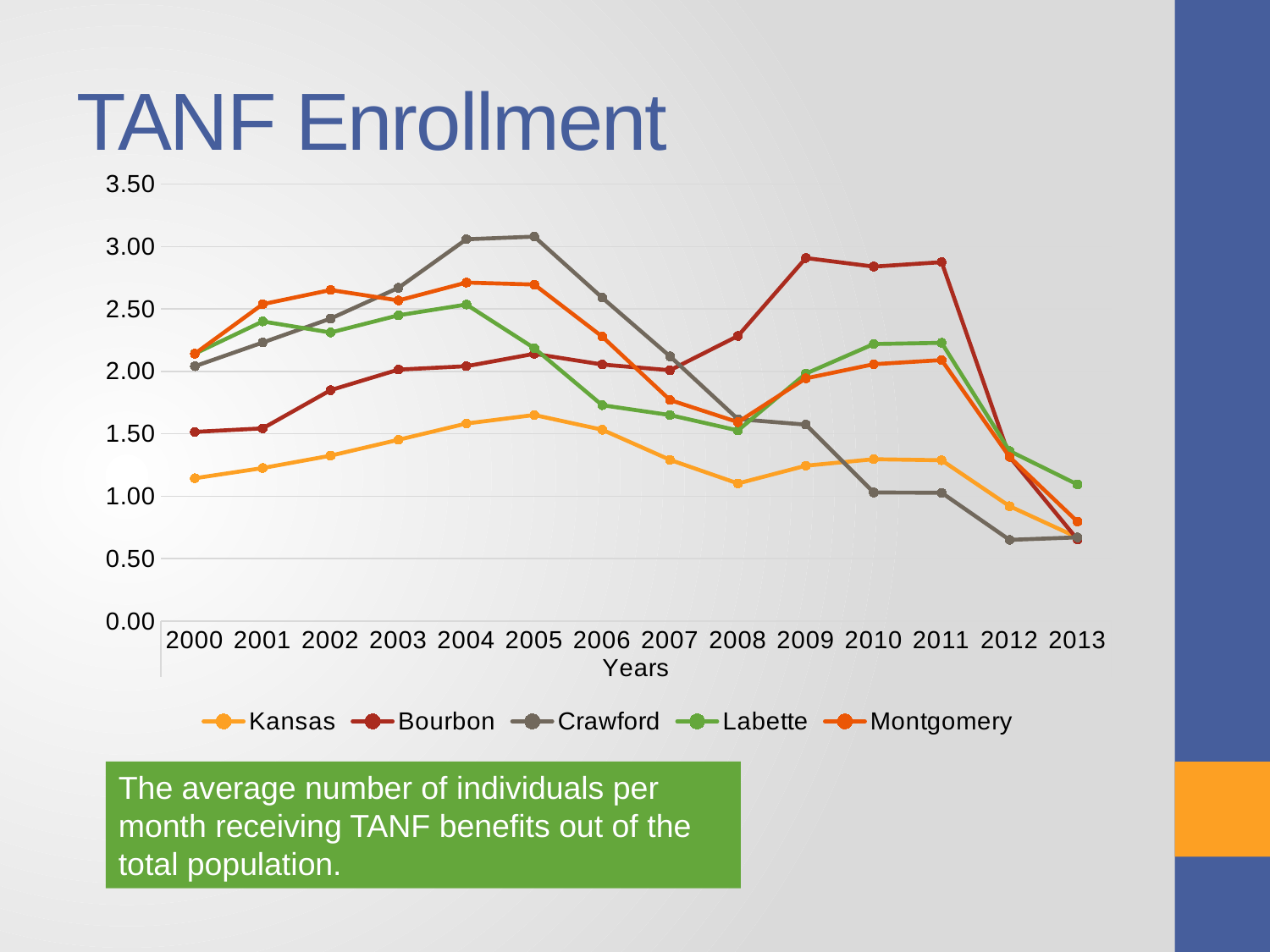
Is the value for Crawford in 2005 greater or less than 2.50? greater Is the value for Crawford in 2012 greater or less than 1.00? less Is the value for Kansas in 2000 greater or less than 1.50? less Which is larger in 2010, the value for Bourbon or the value for Labette? Bourbon What is the title of the x axis? Years How many years are plotted along the x axis? 14 In which year is the Kansas value lowest? 2013 Which series has the highest value in 2009? Bourbon What kind of chart is shown on the slide? line chart Does the Kansas line rise or fall from 2011 to 2013? fall Which series has the lowest value in 2005? Kansas How many series does the legend list? 5